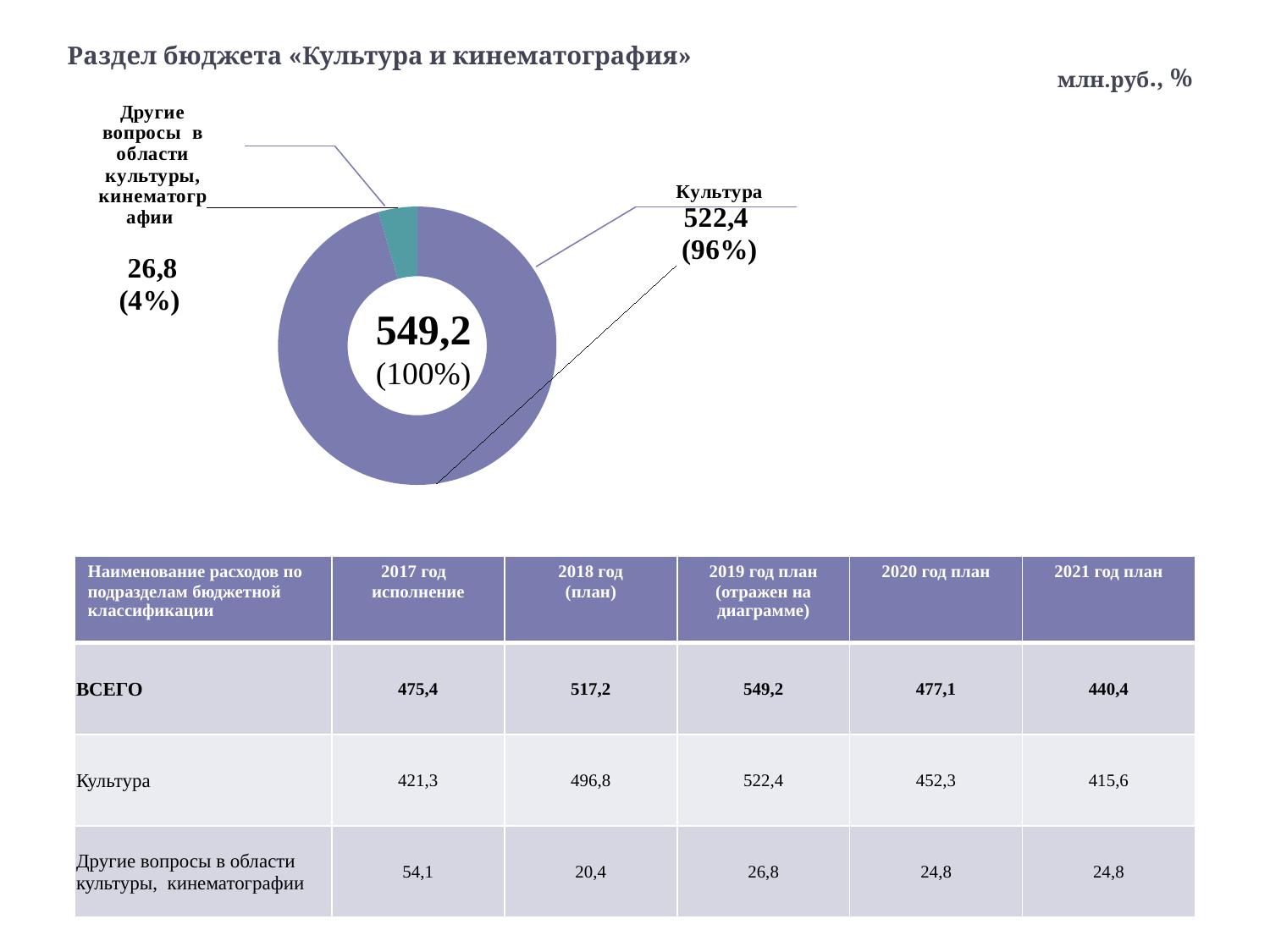
What kind of chart is shown on the slide? Doughnut (pie) chart What share of the doughnut chart does Другие вопросы в области культуры, кинематографии represent? 4% What is the value for Другие вопросы в области культуры, кинематографии in the doughnut chart? 26,8 How many slices does the doughnut chart have? 2 What units are indicated for the chart in the top right of the slide? млн.руб., % What share of the doughnut chart does Культура represent? 96% Which slice of the doughnut chart is the largest? Культура Which slice of the doughnut chart is the smallest? Другие вопросы в области культуры, кинематографии What is the total value shown in the centre of the doughnut chart? 549,2 What is the value for Культура in the doughnut chart? 522,4 Which is larger in the doughnut chart: Культура or Другие вопросы в области культуры, кинематографии? Культура What is the difference between the Культура slice and the Другие вопросы в области культуры, кинематографии slice in the doughnut chart? 495,6